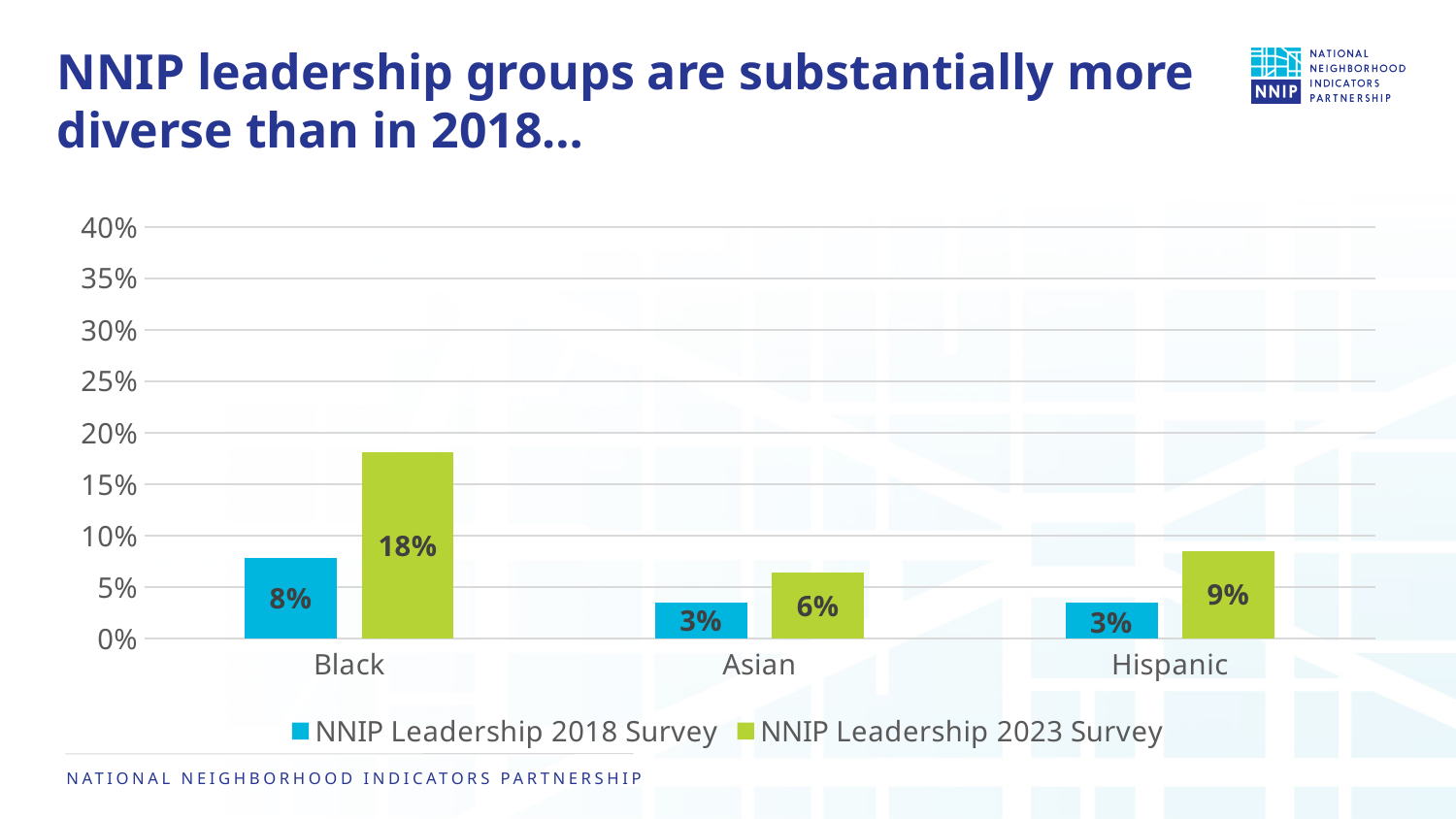
What is the value for Asian in the NNIP Leadership 2018 Survey? 3% What is the difference between the 2023 and 2018 survey values for Black? 10% Is the value for Black in the NNIP Leadership 2023 Survey greater or less than 15%? greater Which category has the highest value in the NNIP Leadership 2023 Survey? Black What is the value for Black in the NNIP Leadership 2023 Survey? 18% Which category has the lowest value in the NNIP Leadership 2023 Survey? Asian How many categories are shown on the x axis? 3 What is the value for Hispanic in the NNIP Leadership 2023 Survey? 9% What is the difference between the 2023 and 2018 survey values for Hispanic? 6% Which is larger for Asian: the 2018 survey value or the 2023 survey value? NNIP Leadership 2023 Survey How many series does the legend list? 2 What kind of chart is shown on the slide? Bar chart